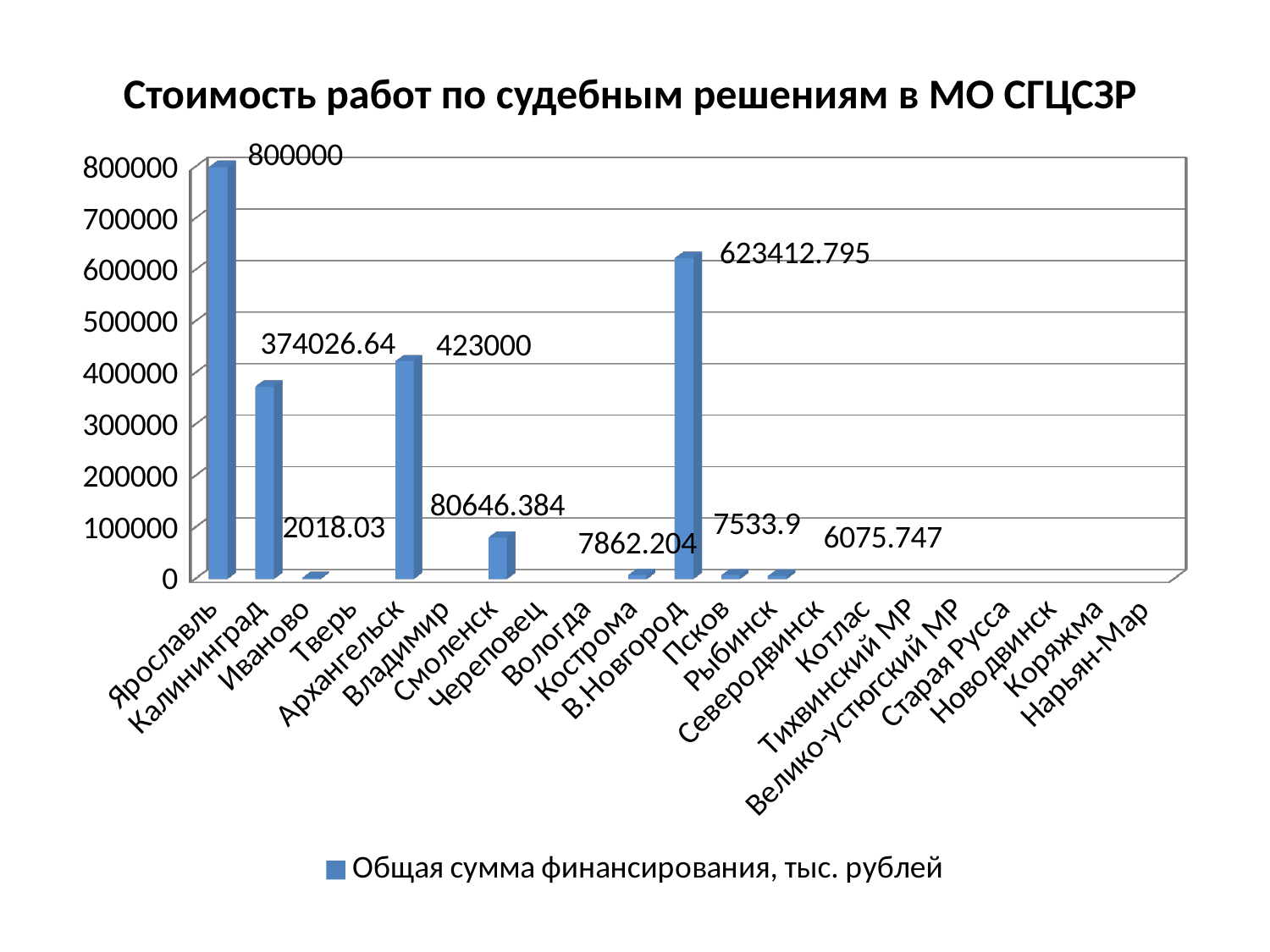
What is the value for Ярославль? 800000 How many series does the legend list? 1 What is the difference between the values for Ярославль and Архангельск? 377000 Which category has the highest value? Ярославль What is the legend entry of the chart? Общая сумма финансирования, тыс. рублей What kind of chart is shown on the slide? bar chart What is the value for Архангельск? 423000 What is the value for В.Новгород? 623412.795 What is the value for Калининград? 374026.64 Which is larger, the value for Архангельск or the value for Калининград? Архангельск Is the value for Смоленск greater or less than 100000? less What is the value for Смоленск? 80646.384